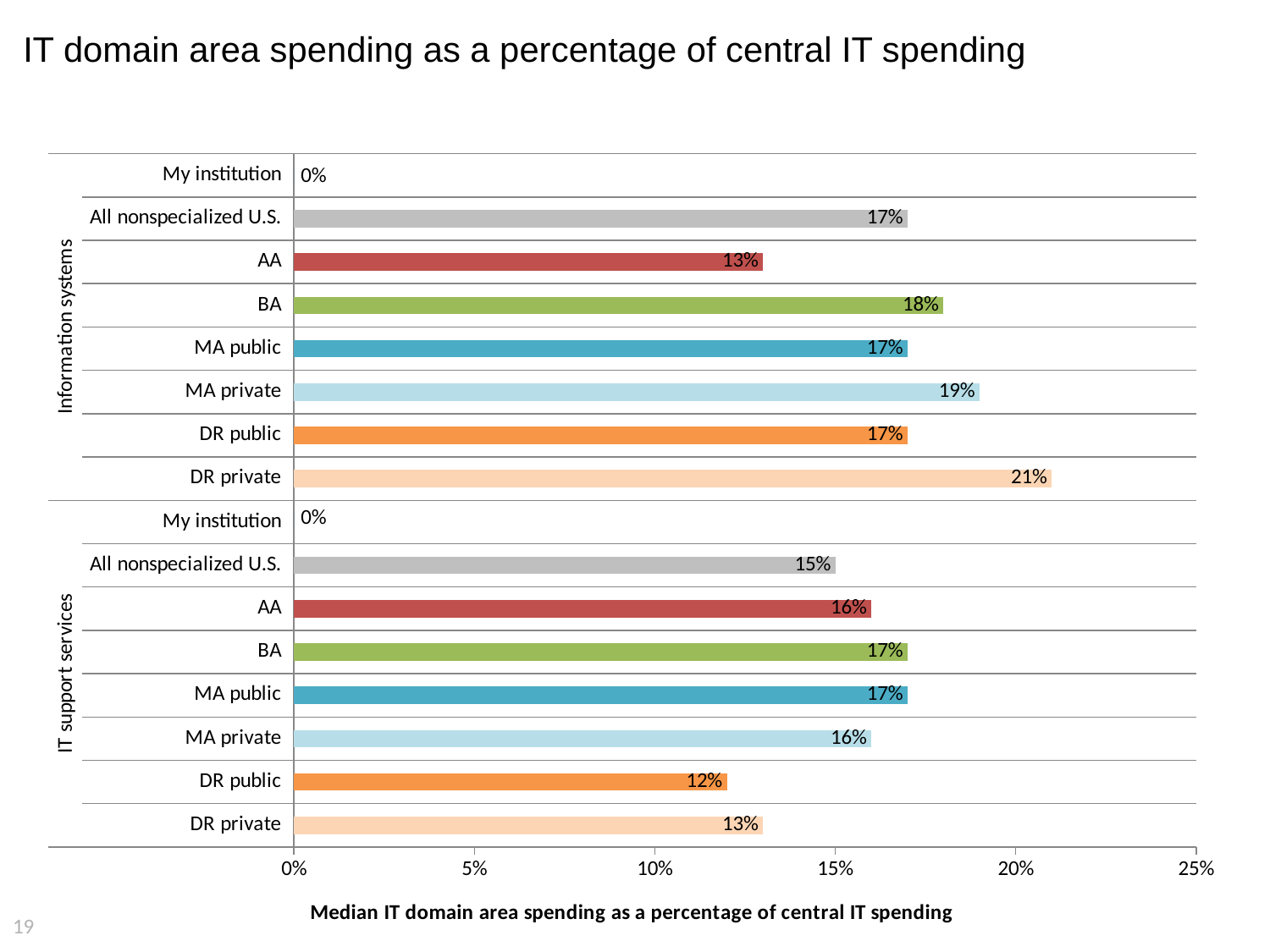
What is the difference between DR private and DR public under Information systems? 4% What is the x-axis title of the chart? Median IT domain area spending as a percentage of central IT spending Which category has the lowest value in the IT support services group, excluding My institution? DR public What is the value for AA under Information systems? 13% How many bars are shown in the IT support services group? 8 What is the value for DR public under IT support services? 12% What kind of chart is shown on the slide? Bar chart Is the value for MA private under Information systems greater or less than 15%? greater Which is larger: BA under Information systems or BA under IT support services? BA under Information systems Which category has the highest value in the Information systems group? DR private What is the value for DR private under Information systems? 21% What is the value for All nonspecialized U.S. under IT support services? 15%